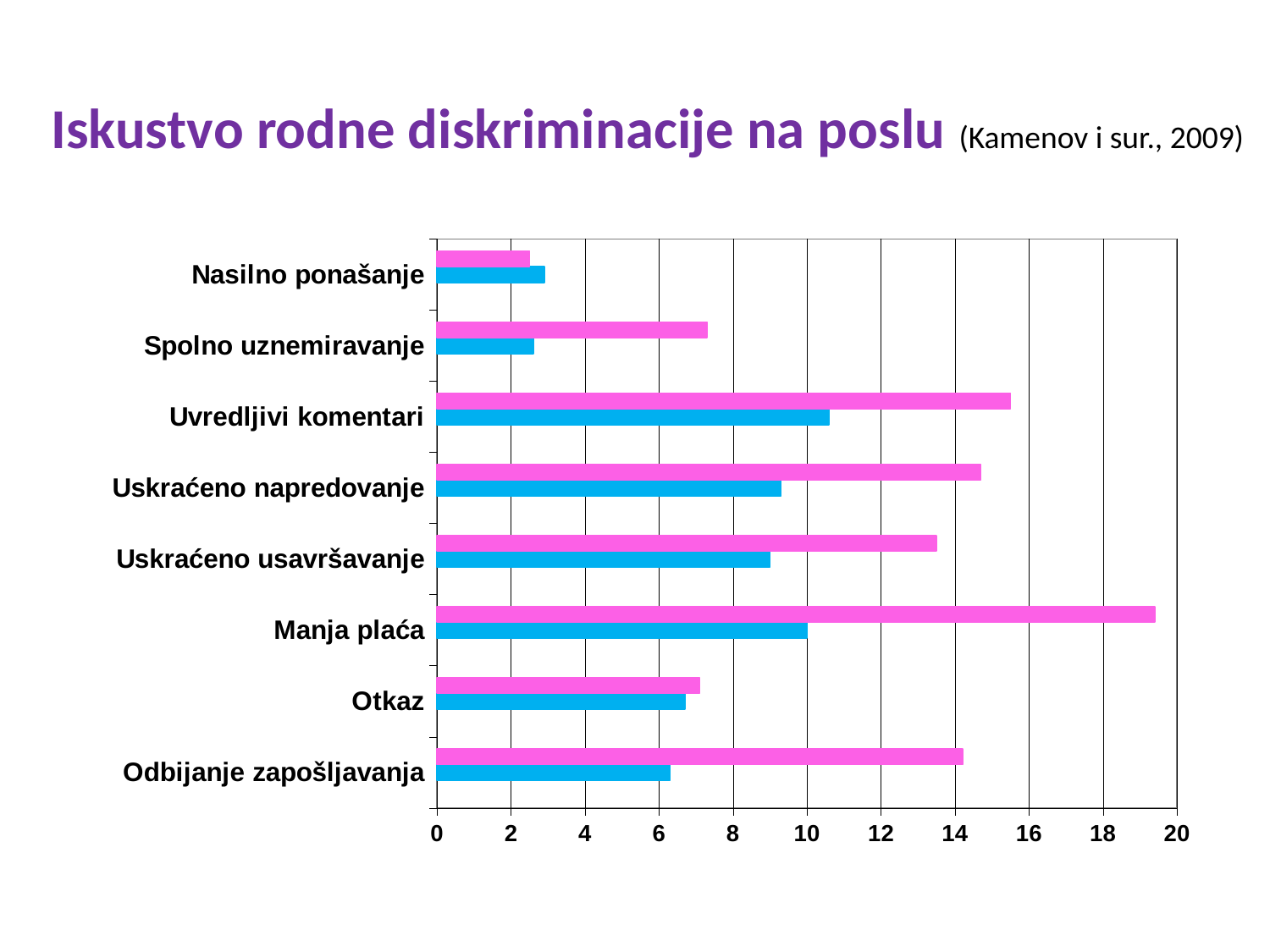
Is the pink bar for Manja plaća greater or less than 18? greater Is the pink bar for Spolno uznemiravanje greater or less than 6? greater Is the pink bar for Uvredljivi komentari greater or less than 14? greater What is the title of the chart on the slide? Iskustvo rodne diskriminacije na poslu Which pink bar is longer, Manja plaća or Odbijanje zapošljavanja? Manja plaća How many categories are shown on the chart? 8 What kind of chart is shown on the slide? bar chart Which category has the longest pink bar? Manja plaća For Odbijanje zapošljavanja, which bar is longer, the pink one or the blue one? the pink one Which category has the shortest pink bar? Nasilno ponašanje